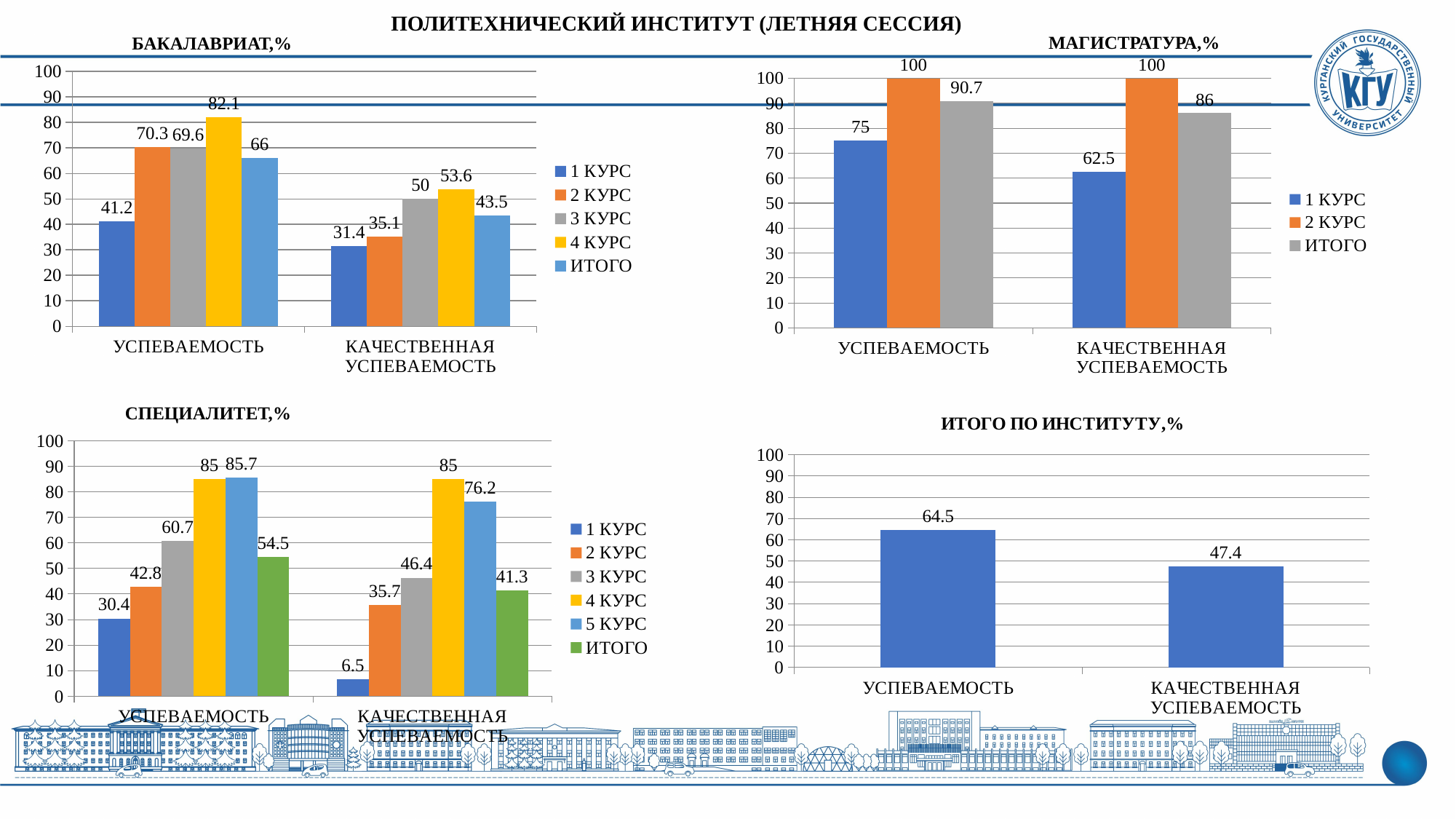
In the ИТОГО ПО ИНСТИТУТУ,% chart, what is the difference between УСПЕВАЕМОСТЬ and КАЧЕСТВЕННАЯ УСПЕВАЕМОСТЬ? 17.1 In the БАКАЛАВРИАТ,% chart, how many series does the legend list? 5 In the МАГИСТРАТУРА,% chart, what is the difference between the ИТОГО values for УСПЕВАЕМОСТЬ and КАЧЕСТВЕННАЯ УСПЕВАЕМОСТЬ? 4.7 In the МАГИСТРАТУРА,% chart, which series has the highest value in the УСПЕВАЕМОСТЬ category? 2 КУРС In the СПЕЦИАЛИТЕТ,% chart, how many series does the legend list? 6 In the СПЕЦИАЛИТЕТ,% chart, what is the value for 1 КУРС in the КАЧЕСТВЕННАЯ УСПЕВАЕМОСТЬ category? 6.5 In the БАКАЛАВРИАТ,% chart, what is the value for 4 КУРС in the УСПЕВАЕМОСТЬ category? 82.1 In the ИТОГО ПО ИНСТИТУТУ,% chart, what is the value for КАЧЕСТВЕННАЯ УСПЕВАЕМОСТЬ? 47.4 What kind of chart is the ИТОГО ПО ИНСТИТУТУ,% chart? bar chart In the СПЕЦИАЛИТЕТ,% chart, which is larger in the УСПЕВАЕМОСТЬ category: 3 КУРС or ИТОГО? 3 КУРС In the МАГИСТРАТУРА,% chart, what is the value for 1 КУРС in the КАЧЕСТВЕННАЯ УСПЕВАЕМОСТЬ category? 62.5 In the БАКАЛАВРИАТ,% chart, which series has the lowest value in the КАЧЕСТВЕННАЯ УСПЕВАЕМОСТЬ category? 1 КУРС